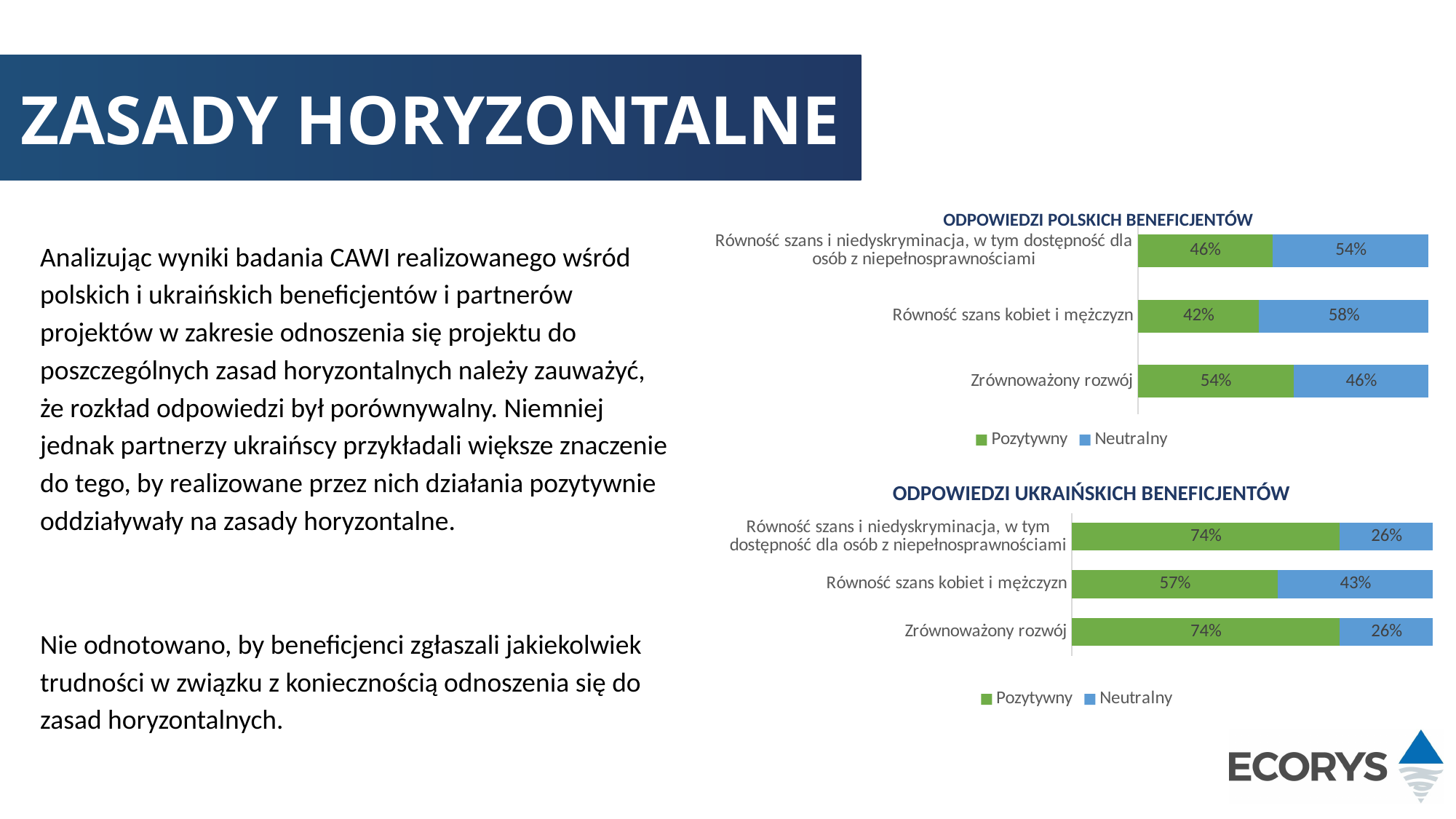
In the chart 'ODPOWIEDZI UKRAIŃSKICH BENEFICJENTÓW', what is the difference between the 'Pozytywny' and 'Neutralny' values for 'Zrównoważony rozwój'? 48% In the chart 'ODPOWIEDZI UKRAIŃSKICH BENEFICJENTÓW', what is the 'Neutralny' value for 'Równość szans i niedyskryminacja, w tym dostępność dla osób z niepełnosprawnościami'? 26% In the chart 'ODPOWIEDZI POLSKICH BENEFICJENTÓW', what is the difference between the 'Neutralny' and 'Pozytywny' values for 'Równość szans kobiet i mężczyzn'? 16% In the chart 'ODPOWIEDZI UKRAIŃSKICH BENEFICJENTÓW', what is the 'Pozytywny' value for 'Równość szans kobiet i mężczyzn'? 57% In the chart 'ODPOWIEDZI POLSKICH BENEFICJENTÓW', what is the 'Neutralny' value for 'Zrównoważony rozwój'? 46% What type of chart is 'ODPOWIEDZI POLSKICH BENEFICJENTÓW'? Stacked bar chart In the chart 'ODPOWIEDZI POLSKICH BENEFICJENTÓW', which category has the highest 'Pozytywny' value? Zrównoważony rozwój How many series does the legend of the chart 'ODPOWIEDZI POLSKICH BENEFICJENTÓW' list? 2 In the chart 'ODPOWIEDZI POLSKICH BENEFICJENTÓW', what is the 'Pozytywny' value for 'Równość szans kobiet i mężczyzn'? 42% How many categories are shown in the chart 'ODPOWIEDZI UKRAIŃSKICH BENEFICJENTÓW'? 3 Which is larger: the 'Pozytywny' value for 'Zrównoważony rozwój' in the Polish beneficiaries chart or in the Ukrainian beneficiaries chart? Ukrainian beneficiaries chart In the chart 'ODPOWIEDZI UKRAIŃSKICH BENEFICJENTÓW', which category has the lowest 'Pozytywny' value? Równość szans kobiet i mężczyzn